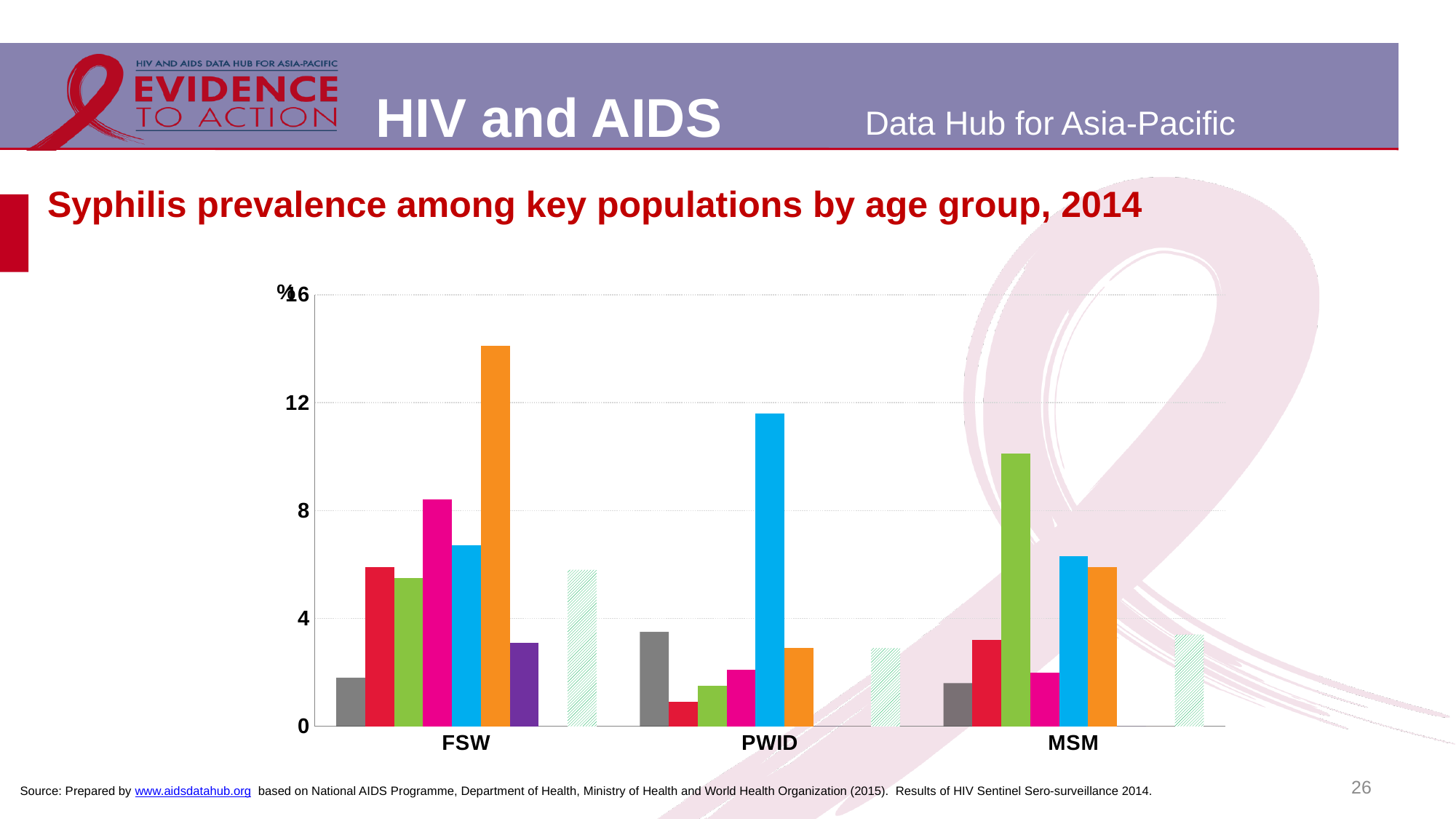
How many key population categories are shown on the x axis? 3 What is the title of the chart? Syphilis prevalence among key populations by age group, 2014 Which key population category contains the tallest bar in the chart? FSW Which is larger: the grey bar for PWID or the grey bar for MSM? the grey bar for PWID Is the value of the green bar for MSM greater or less than 8? greater What kind of chart is shown on the slide? bar chart What is the highest value shown on the y axis? 16 Is the value of the orange bar for FSW greater or less than 12? greater Which is larger: the orange bar for FSW or the orange bar for PWID? the orange bar for FSW Is the value of the blue bar for PWID greater or less than 12? less